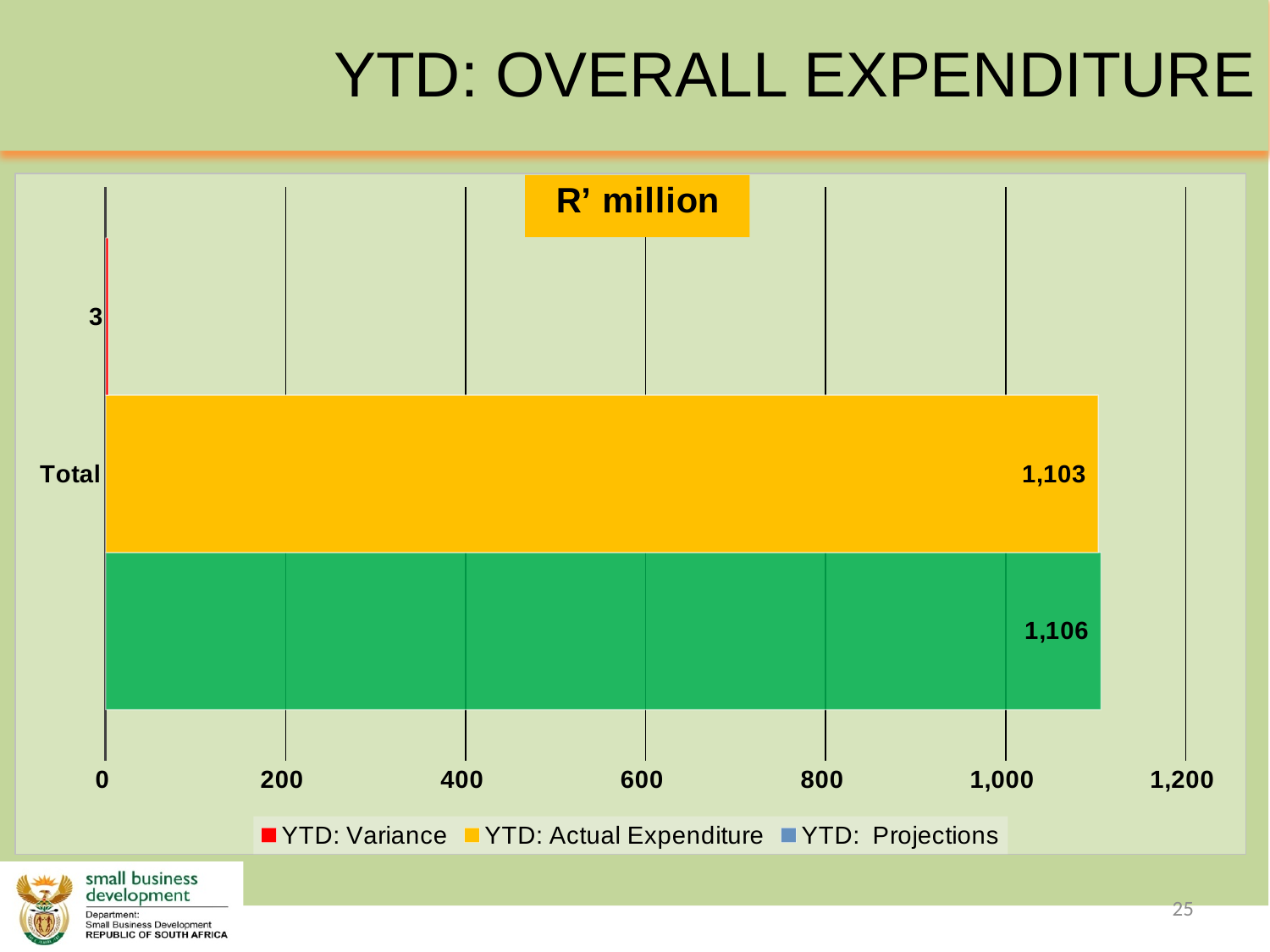
What is the value of YTD: Actual Expenditure for Total? 1,103 Which series has the lowest value for Total? YTD: Variance What is the title shown inside the chart area? R' million What kind of chart is shown on the slide? Bar chart What is the difference between YTD: Projections and YTD: Actual Expenditure for Total? 3 Which series has the highest value for Total? YTD: Projections Which is larger for Total, YTD: Actual Expenditure or YTD: Projections? YTD: Projections What is the value of YTD: Variance for Total? 3 Is the value for YTD: Actual Expenditure greater or less than 1,000? greater How many series does the legend list? 3 What is the value of YTD: Projections for Total? 1,106 How many categories are shown on the vertical axis? 1